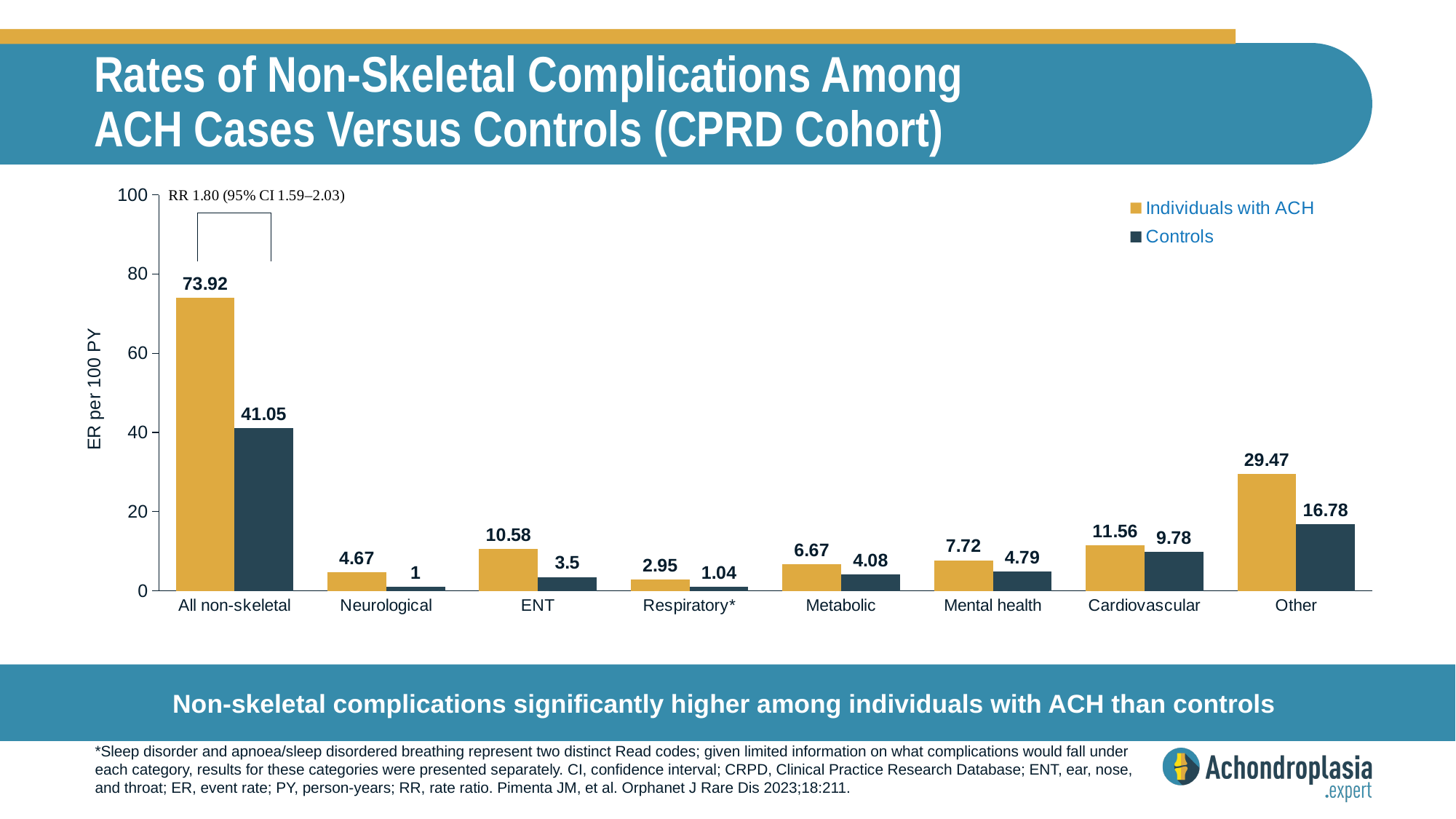
How many categories are shown on the x axis? 8 Which is larger: the Controls value for Cardiovascular or the Controls value for Mental health? Cardiovascular Which category has the highest value for Controls? All non-skeletal Which category has the lowest value for Individuals with ACH? Respiratory* Is the value for Individuals with ACH in the Other category greater or less than 20? greater What is the event rate per 100 PY for Individuals with ACH in the All non-skeletal category? 73.92 What is the value for Individuals with ACH in the Cardiovascular category? 11.56 What is the event rate per 100 PY for Controls in the Other category? 16.78 What kind of chart is shown on the slide? Bar chart What is the difference between the Individuals with ACH and Controls values in the All non-skeletal category? 32.87 What is the difference between the Individuals with ACH and Controls values in the ENT category? 7.08 How many series does the legend list? 2